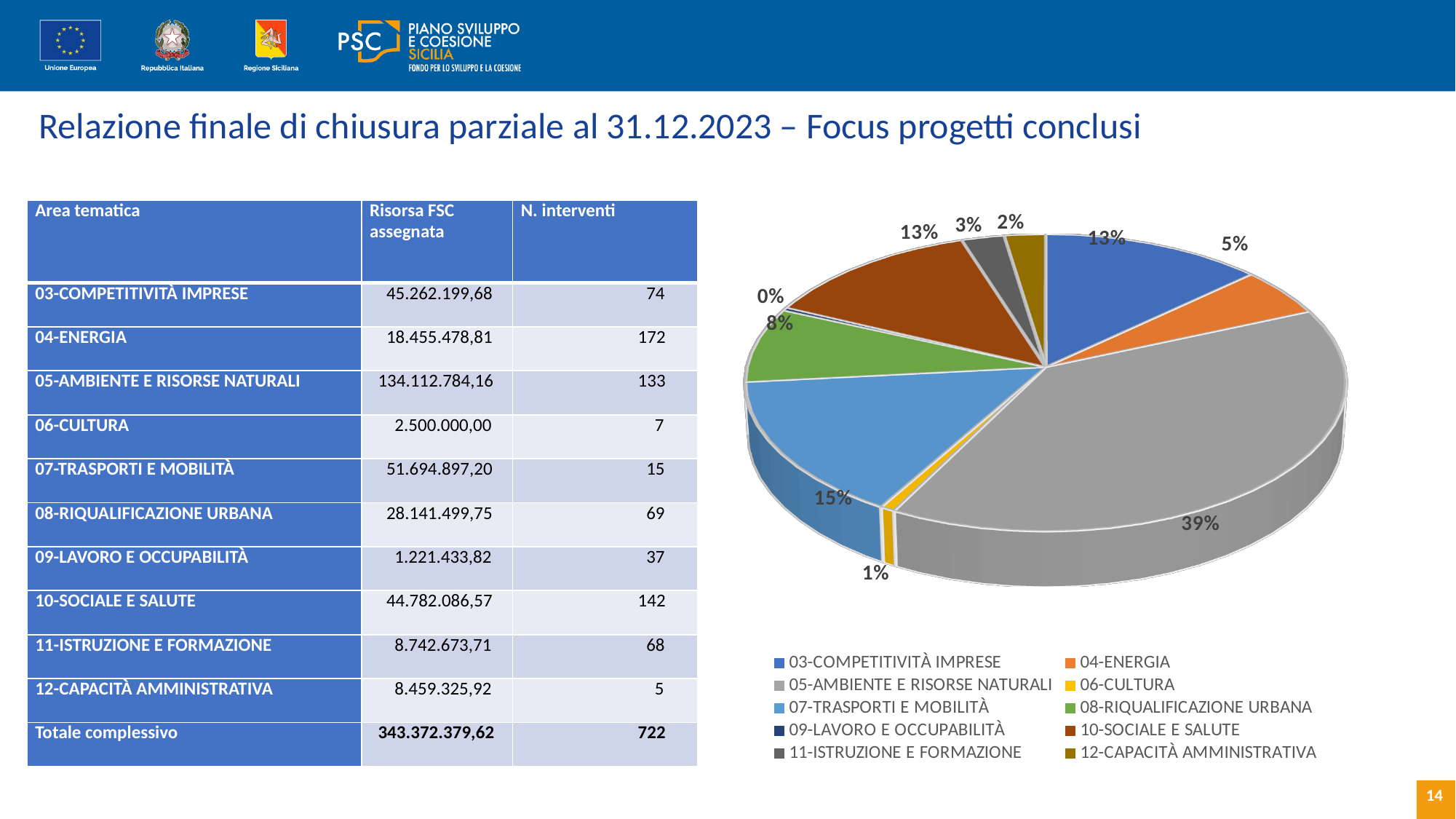
What percentage is shown for 08-RIQUALIFICAZIONE URBANA in the pie chart? 8% What kind of chart is shown on the slide? pie chart How many categories does the pie chart legend list? 10 Which category has the smallest slice of the pie chart? 09-LAVORO E OCCUPABILITÀ What share of the pie does 05-AMBIENTE E RISORSE NATURALI represent? 39% What is the difference in percentage points between the 05-AMBIENTE E RISORSE NATURALI slice and the 07-TRASPORTI E MOBILITÀ slice? 24 percentage points Which category has the largest slice of the pie chart? 05-AMBIENTE E RISORSE NATURALI What percentage is shown for 06-CULTURA in the pie chart? 1% What percentage is shown for 07-TRASPORTI E MOBILITÀ in the pie chart? 15% What percentage is shown for 04-ENERGIA in the pie chart? 5% Which slice is larger in the pie chart: 07-TRASPORTI E MOBILITÀ or 08-RIQUALIFICAZIONE URBANA? 07-TRASPORTI E MOBILITÀ What colour is the 10-SOCIALE E SALUTE slice in the pie chart? brown